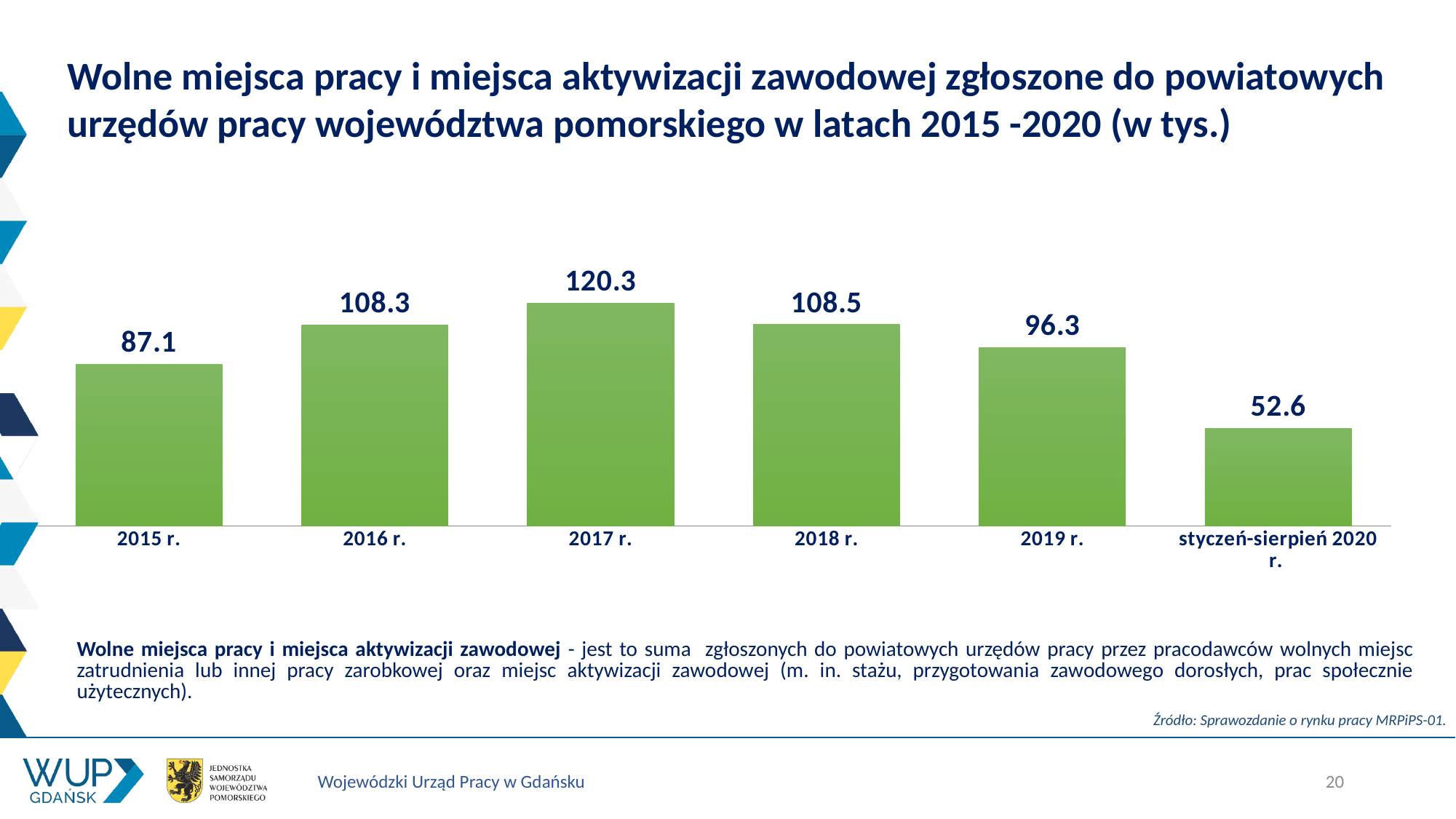
What kind of chart is shown on the slide? bar chart What is the difference between the values for 2018 r. and 2016 r.? 0.2 What is the value for 2015 r.? 87.1 Do the values rise or fall from 2017 r. to styczeń-sierpień 2020 r.? fall Which is larger, the value for 2016 r. or the value for 2019 r.? 2016 r. What colour are the bars in the chart? green What is the difference between the values for 2017 r. and 2019 r.? 24.0 How many categories are shown on the x axis? 6 Which category has the lowest value? styczeń-sierpień 2020 r. Which category has the highest value? 2017 r. What is the value for 2017 r.? 120.3 What is the value for styczeń-sierpień 2020 r.? 52.6